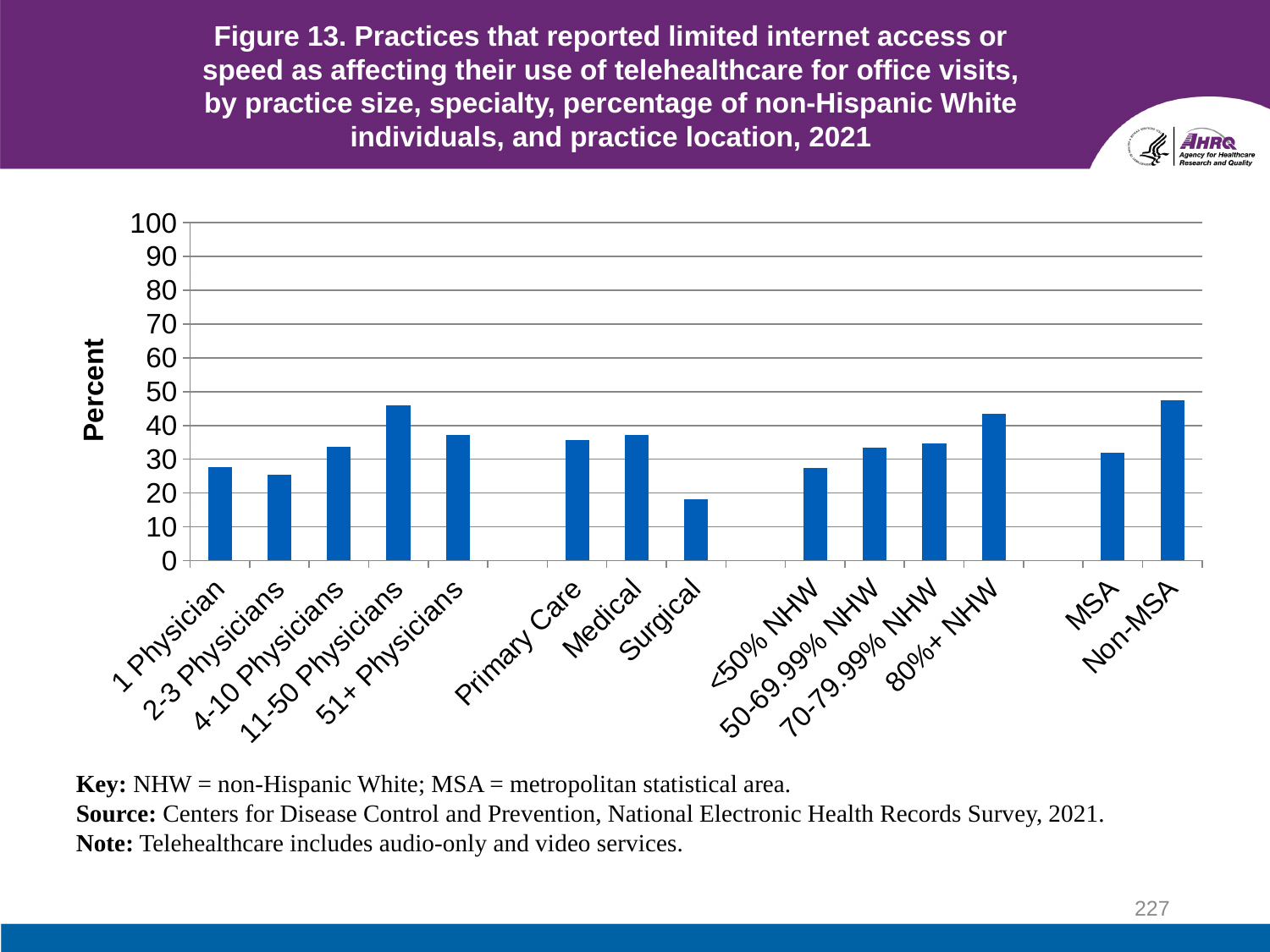
Is the value for Surgical greater or less than 20? less How many categories (bars) are plotted in the chart? 14 Which is larger, the value for 11-50 Physicians or the value for 1 Physician? 11-50 Physicians Is the value for Non-MSA greater or less than 40? greater Is the value for 2-3 Physicians greater or less than 20? greater Which category has the lowest value in the chart? Surgical What kind of chart is shown on the slide? bar chart Which is larger, the value for Medical or the value for Surgical? Medical Which is larger, the value for Non-MSA or the value for MSA? Non-MSA What is the label on the vertical axis of the chart? Percent